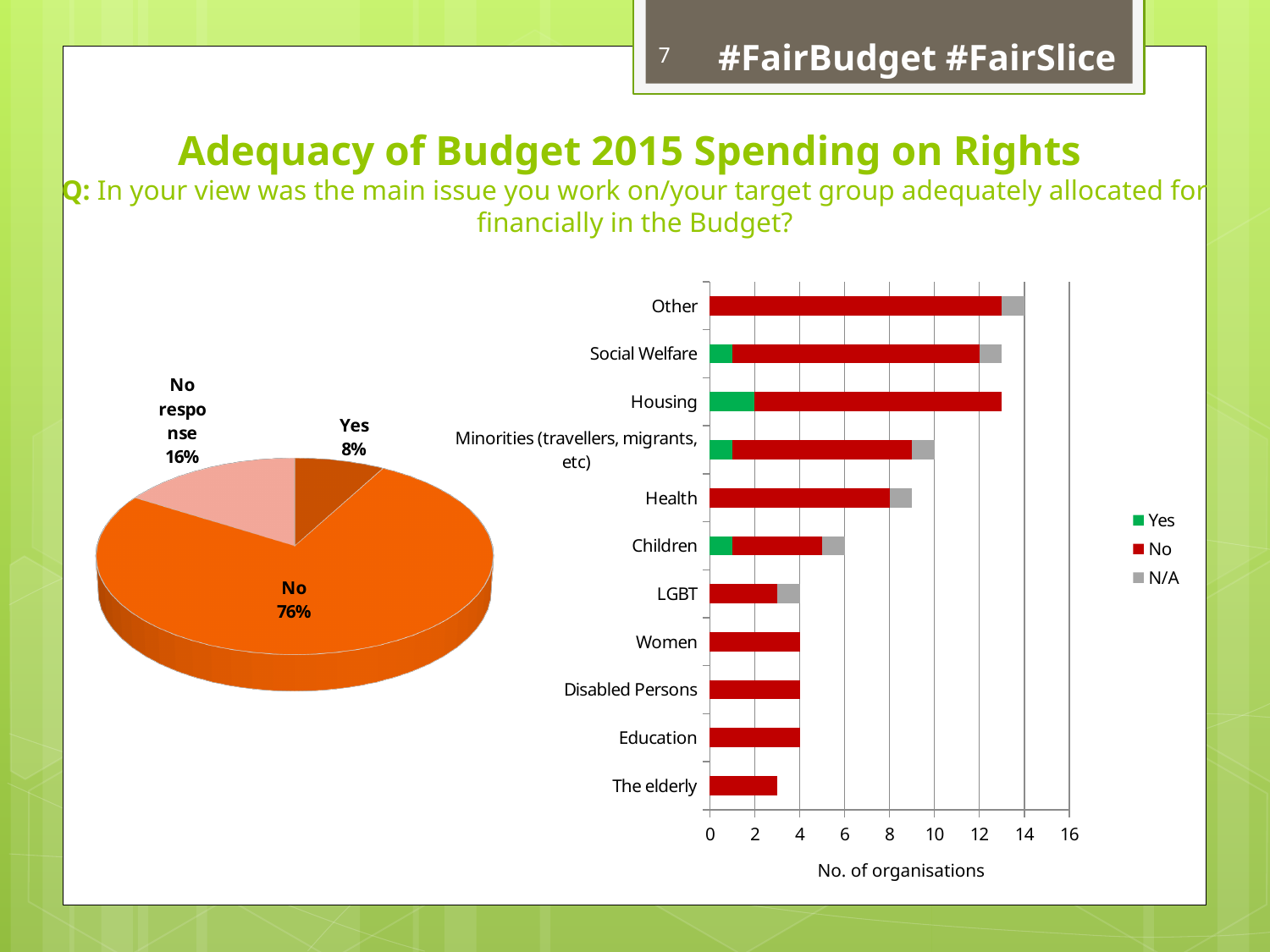
In the bar chart on the right, is the total number of organisations for The elderly greater or less than 4? less In the pie chart on the left, what share is labelled "No response"? 16% What kind of chart is on the right side of the slide? Bar chart What is the x-axis title of the bar chart on the right? No. of organisations How many categories are shown on the bar chart on the right? 11 How many series does the legend of the bar chart on the right list? 3 In the pie chart on the left, which response has the largest slice? No In the pie chart on the left, what percentage of respondents answered "No"? 76% In the pie chart on the left, what is the difference in percentage points between "No" and "No response"? 60 In the pie chart on the left, what percentage of respondents answered "Yes"? 8% In the bar chart on the right, is the total number of organisations for Housing greater or less than 10? greater In the pie chart on the left, which response has the smallest slice? Yes